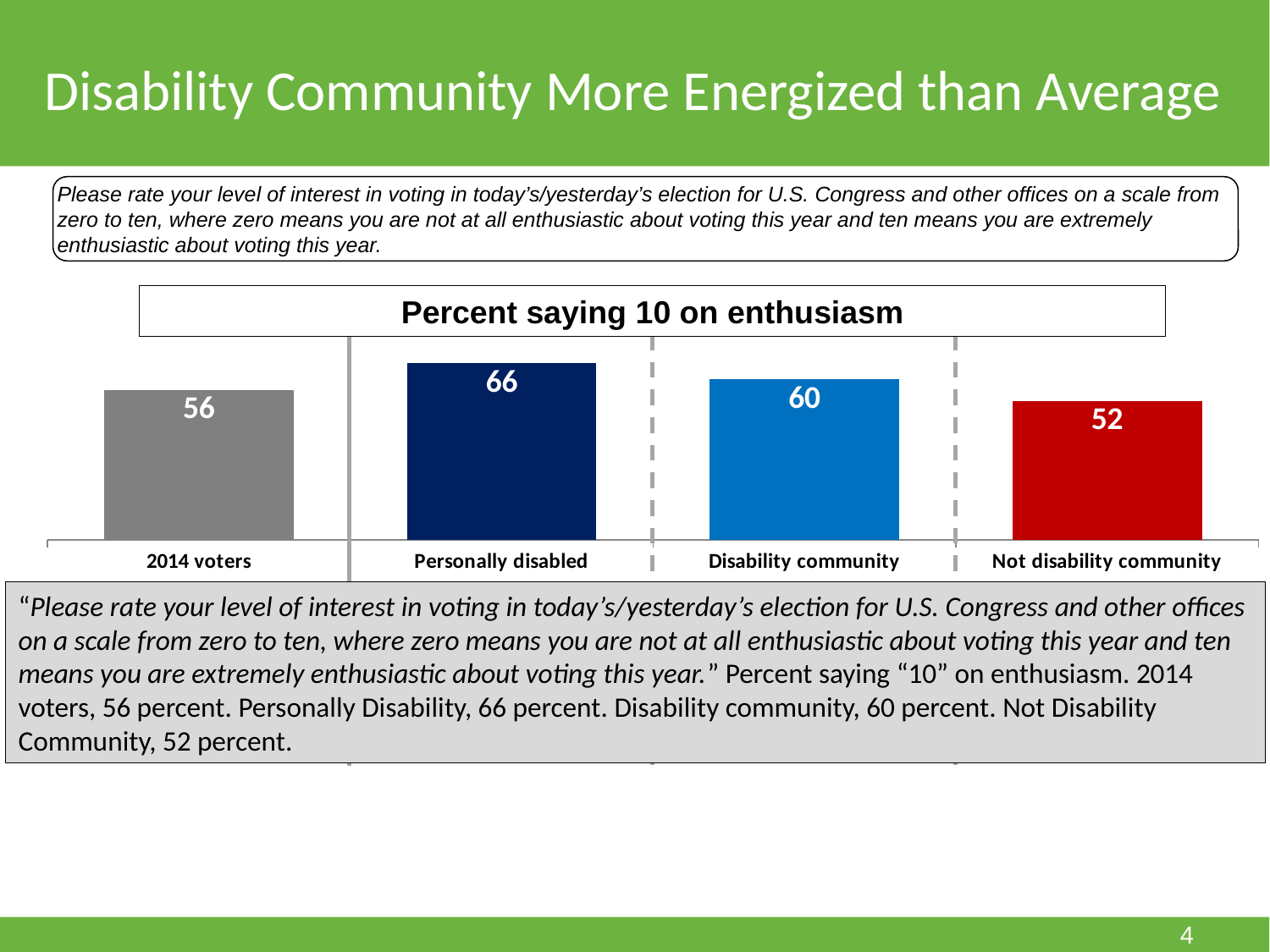
What kind of chart is shown on the slide? Bar chart What is the difference between the values for Personally disabled and 2014 voters? 10 Which is larger, the value for Disability community or the value for 2014 voters? Disability community What is the value for Personally disabled? 66 How many categories are shown in the chart? 4 What is the value for 2014 voters? 56 Which category has the highest value? Personally disabled What is the value for Disability community? 60 What is the title of the chart? Percent saying 10 on enthusiasm What is the difference between the values for Disability community and Not disability community? 8 Which category has the lowest value? Not disability community What is the value for Not disability community? 52